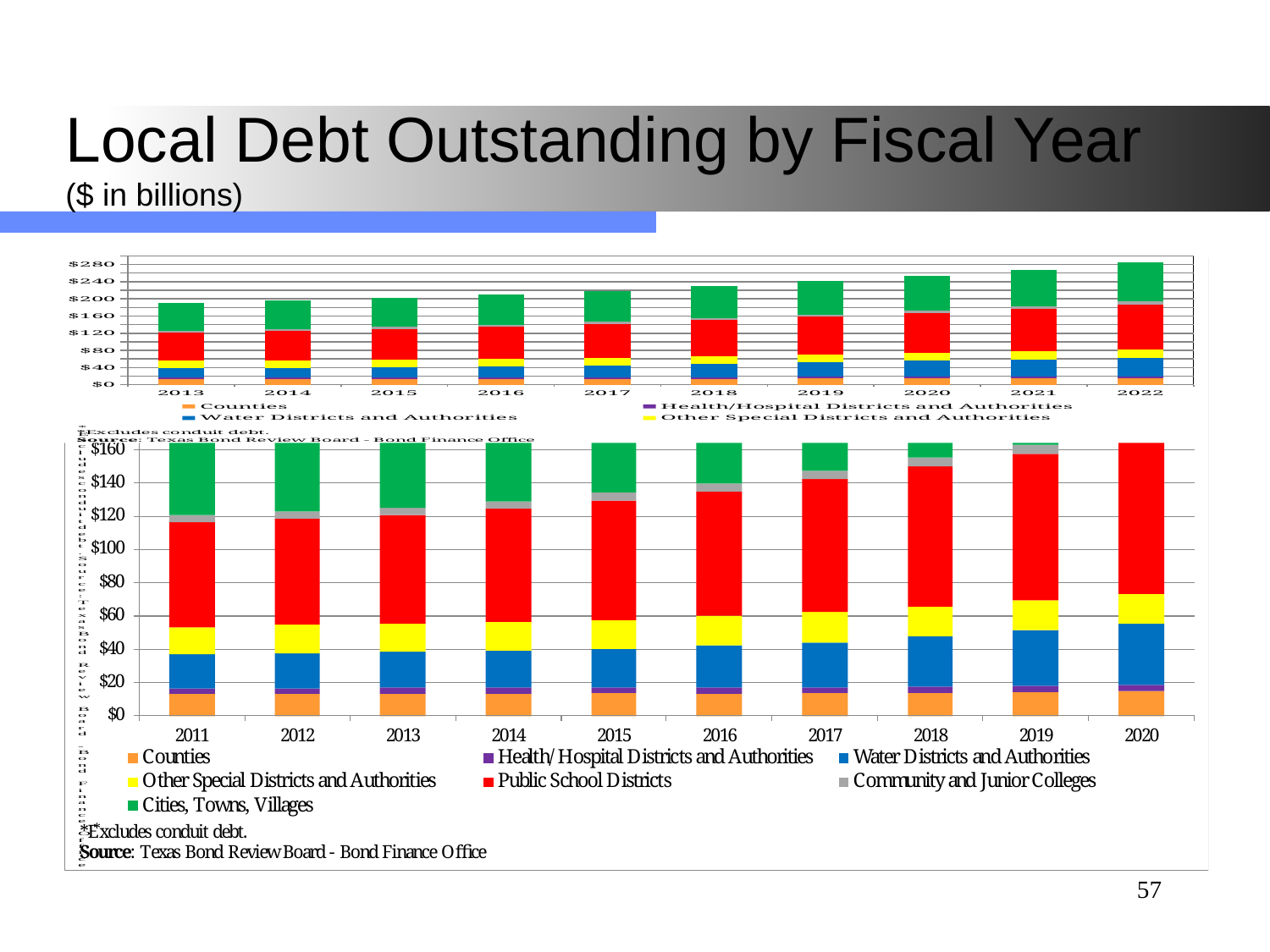
In the top chart, which fiscal year has the shortest total bar? 2013 In the bottom chart, is the Counties value for 2011 greater or less than $20? less In the top chart, is the total bar for 2013 greater or less than $200? less What kind of chart is the top chart on the slide? Stacked bar chart In the top chart, which fiscal year has the tallest total bar? 2022 In the top chart, is the total bar for 2022 greater or less than $240? greater In the bottom chart, does the Water Districts and Authorities segment grow or shrink from 2011 to 2020? Grow How many fiscal years are shown on the x axis of the top chart? 10 In the bottom chart, what colour represents Public School Districts? Red How many fiscal years are shown on the x axis of the bottom chart? 10 In the top chart, do the total bars rise or fall from 2013 to 2022? Rise How many series does the legend of the bottom chart list? 7